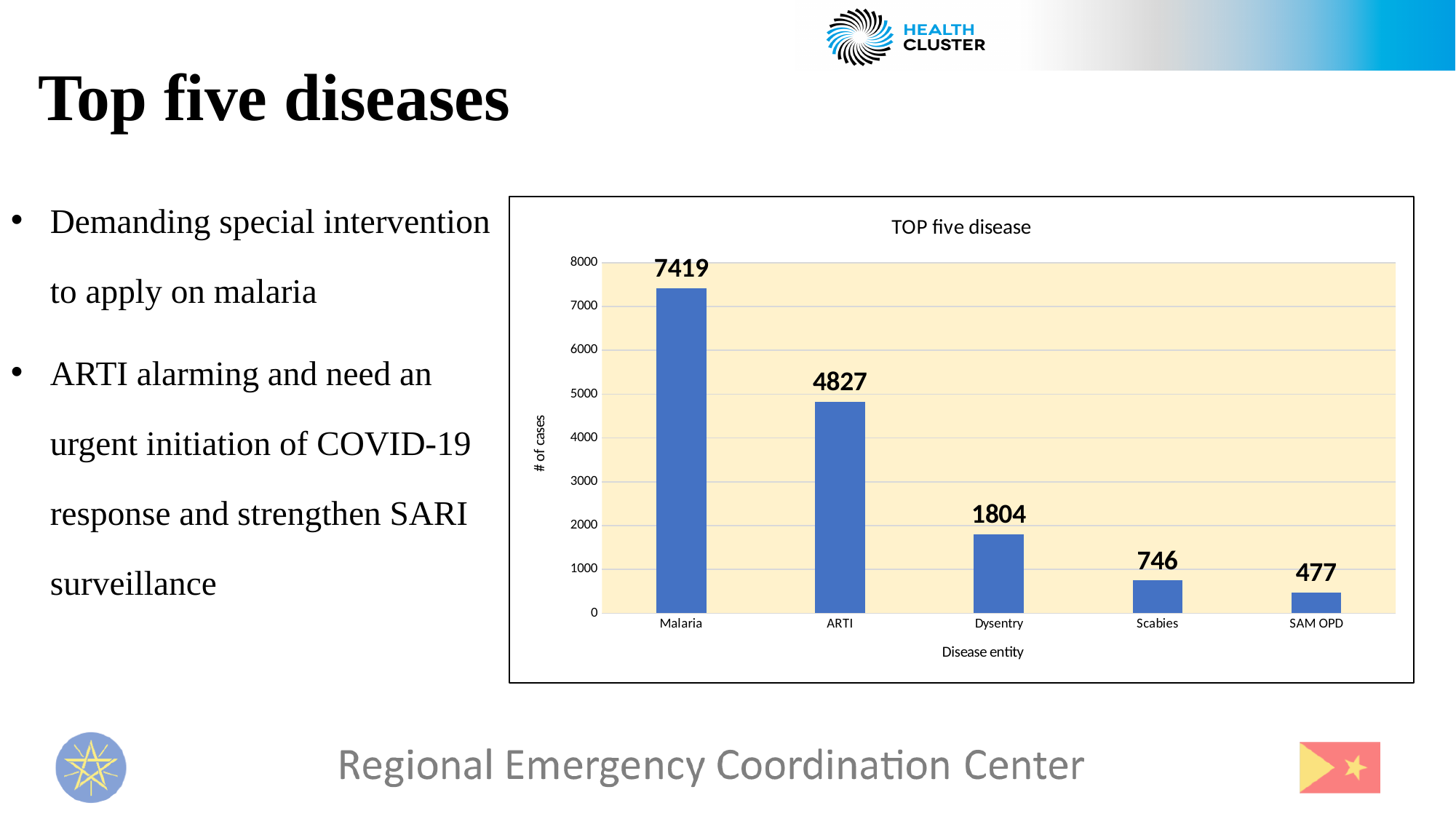
Which disease entity has the lowest number of cases? SAM OPD What is the number of cases for Dysentry? 1804 What is the number of cases for SAM OPD? 477 Which disease entity has the highest number of cases? Malaria Which has more cases, Dysentry or Scabies? Dysentry How many disease entities are shown in the chart? 5 What type of chart is shown on the slide? Bar chart What is the title of the chart? TOP five disease What is the difference in cases between Malaria and ARTI? 2592 What is the number of cases for ARTI? 4827 What is the difference in cases between Scabies and SAM OPD? 269 What is the number of cases for Malaria? 7419